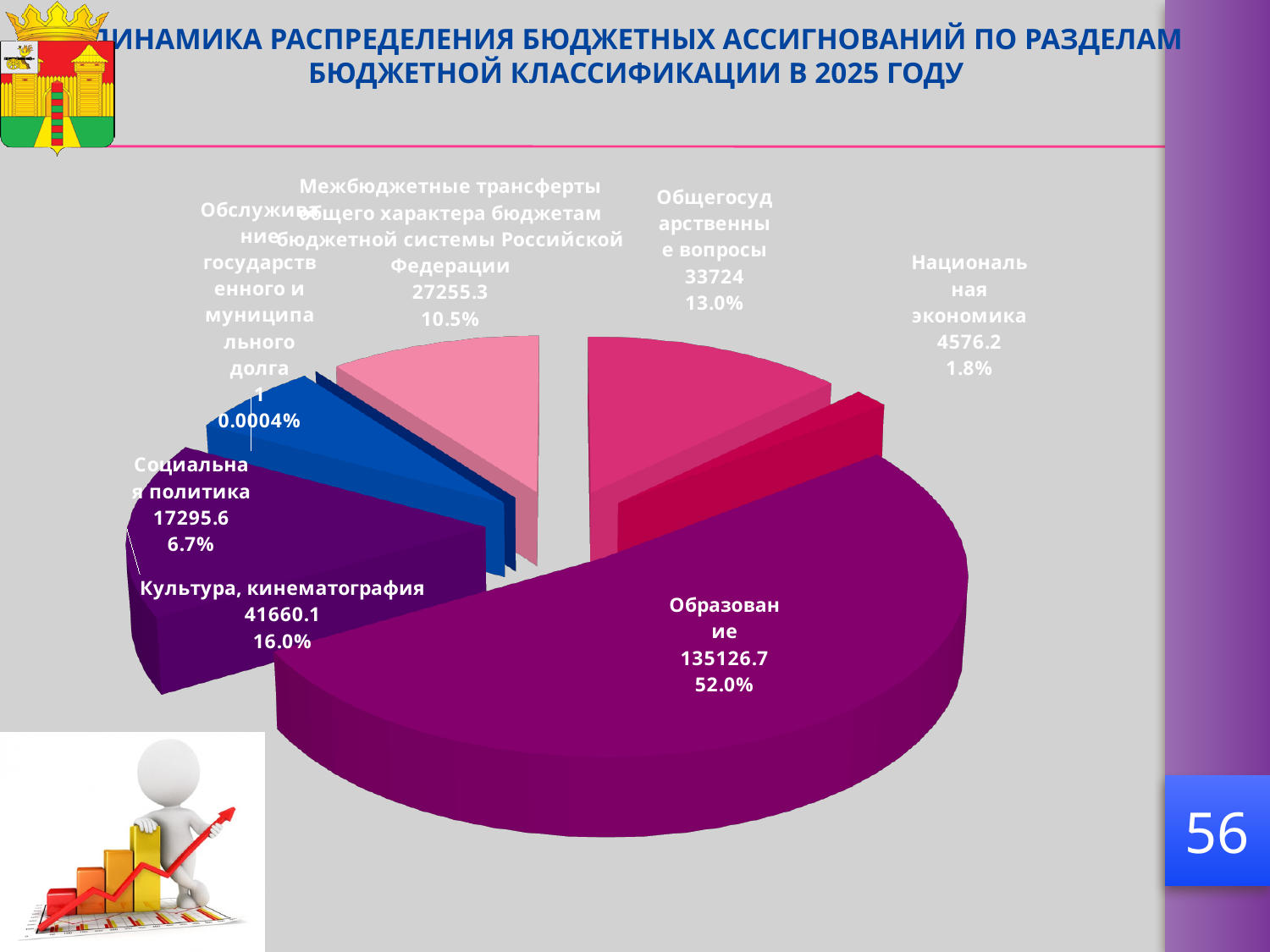
What value is shown for Образование? 135126.7 What is the difference between the values for Культура, кинематография and Социальная политика? 24364.5 Which category has the largest slice of the pie? Образование What type of chart is shown on the slide? Pie chart What percentage share is shown for Культура, кинематография? 16.0% What year does the chart title refer to? 2025 What percentage share is shown for Национальная экономика? 1.8% What value is shown for Социальная политика? 17295.6 How many slices (categories) does the pie chart have? 7 Which is larger: the value for Межбюджетные трансферты общего характера бюджетам бюджетной системы Российской Федерации or the value for Общегосударственные вопросы? Общегосударственные вопросы Which category has the smallest slice of the pie? Обслуживание государственного и муниципального долга What value is shown for Общегосударственные вопросы? 33724